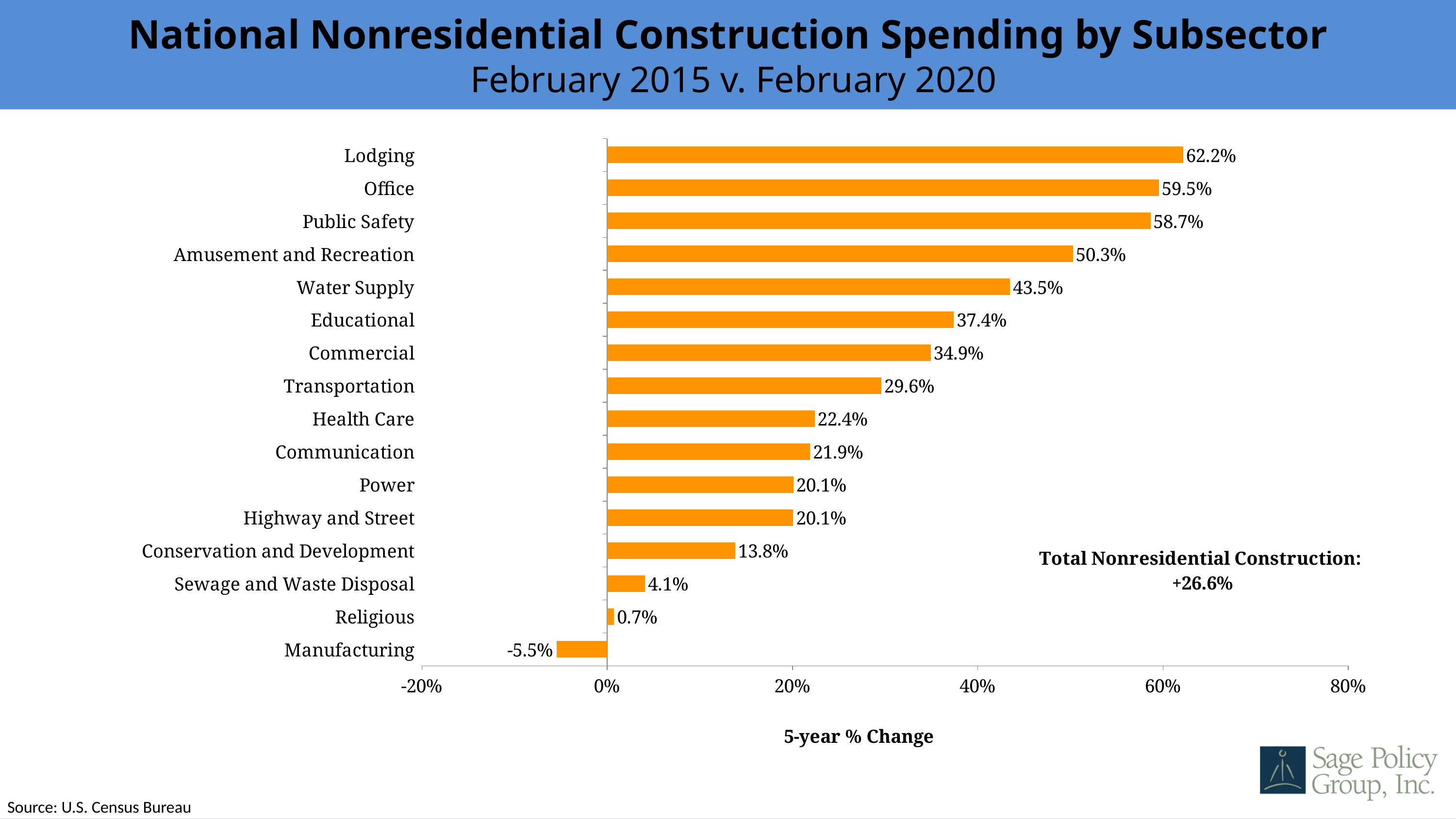
What is the 5-year % change for Water Supply? 43.5% Which has a larger 5-year % change, Educational or Commercial? Educational What is the 5-year % change for Manufacturing? -5.5% Is the value for Amusement and Recreation greater or less than 40%? greater What is the difference between the 5-year % change for Office and for Public Safety? 0.8% Which subsector has the lowest 5-year % change? Manufacturing How many subsectors are shown in the chart? 16 What kind of chart is shown on the slide? Bar chart What is the 5-year % change for Total Nonresidential Construction noted on the chart? +26.6% What is the label of the horizontal axis? 5-year % Change Which subsector has the highest 5-year % change? Lodging What is the 5-year % change for Lodging? 62.2%